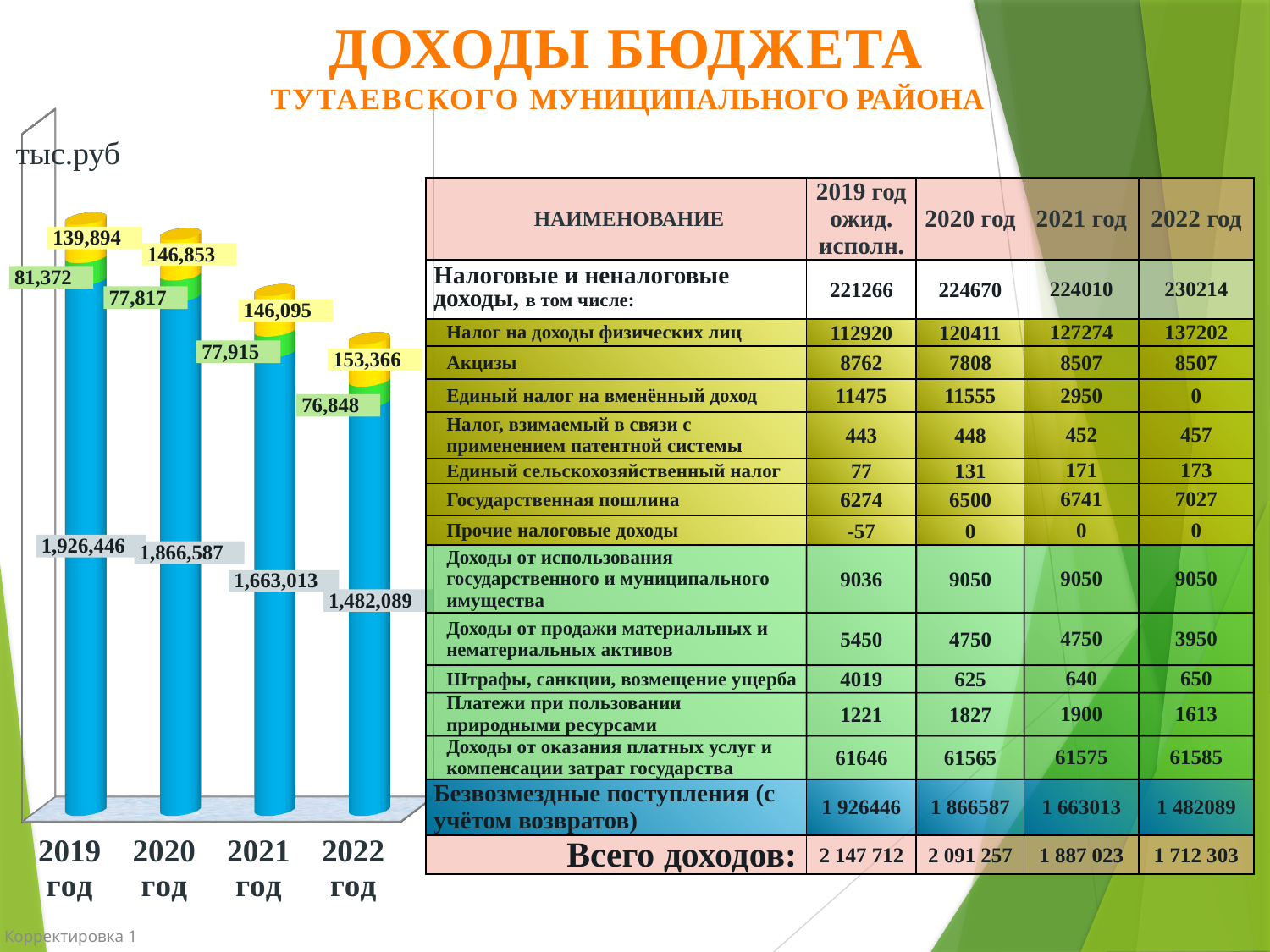
Is the green (middle) segment larger for 2019 год or for 2022 год in the bar chart? 2019 год What unit is indicated for the values in the bar chart? тыс.руб How many years (bars) are shown in the bar chart? 4 What is the value of the blue segment for 2019 год in the bar chart? 1,926,446 What kind of chart is shown on the left of the slide? Stacked bar chart Which year has the highest value for the blue segment in the bar chart? 2019 год What is the value of the green (middle) segment for 2021 год in the bar chart? 77,915 What is the value of the yellow (top) segment for 2022 год in the bar chart? 153,366 Which year has the lowest value for the yellow (top) segment in the bar chart? 2019 год What is the total of the stacked bar for 2022 год in the bar chart? 1,712,303 Do the blue segment values rise or fall from 2019 год to 2022 год in the bar chart? Fall What is the difference between the blue segment values for 2019 год and 2022 год in the bar chart? 444,357